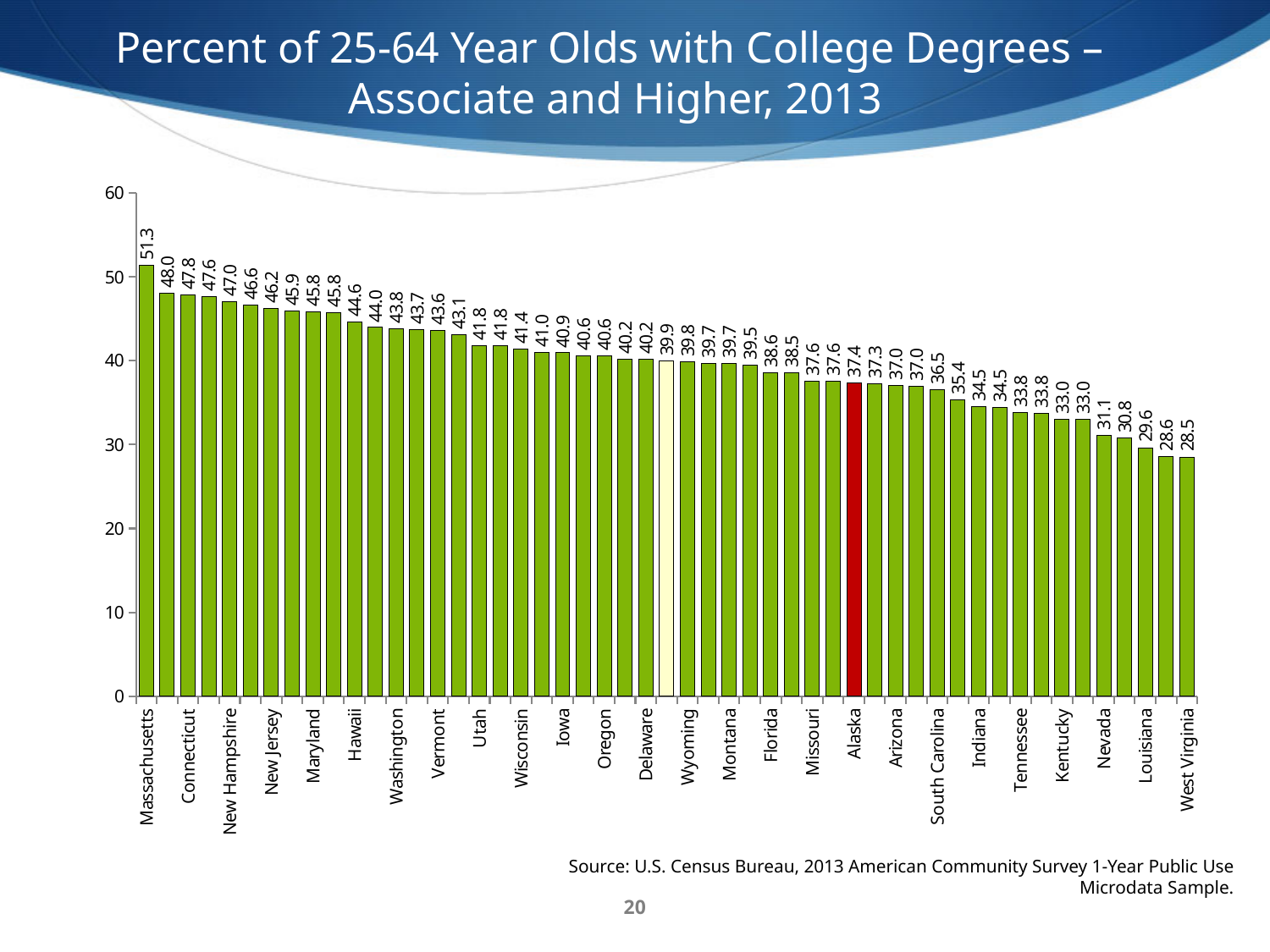
What is the value for West Virginia? 28.5 What is the value for Massachusetts? 51.3 Which state has the highest value? Massachusetts Do the values rise or fall from left to right along the x axis? fall What is the difference between the values for Massachusetts and Alaska? 13.9 Which has a larger value, Utah or Iowa? Utah Is the value for Nevada greater or less than 40? less Which state's bar is coloured red? Alaska What is the difference between the values for Massachusetts and West Virginia? 22.8 What is the value for Florida? 38.6 Which state has the lowest value? West Virginia What is the value for Alaska? 37.4